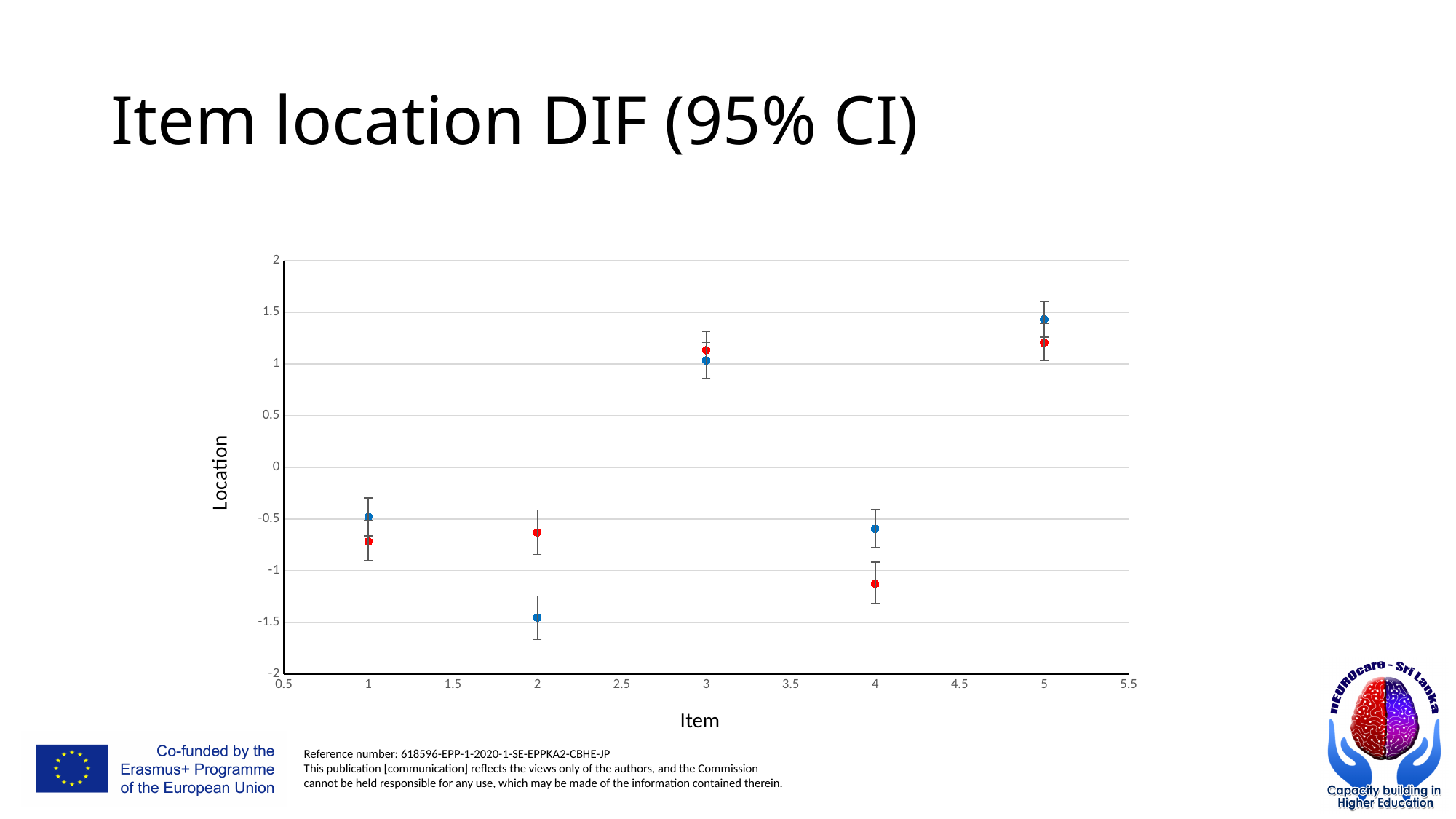
Is the red point for item 4 greater or less than -1? less What is the label of the y axis? Location Is the red point for item 3 greater or less than 1? greater Is the red point for item 1 greater or less than -0.5? less At item 2, which point is higher, the blue one or the red one? Red For which item is the blue series lowest? Item 2 What is the label of the x axis? Item For which item is the blue series highest? Item 5 How many items are plotted along the x axis? 5 What kind of chart is shown on the slide? Scatter plot